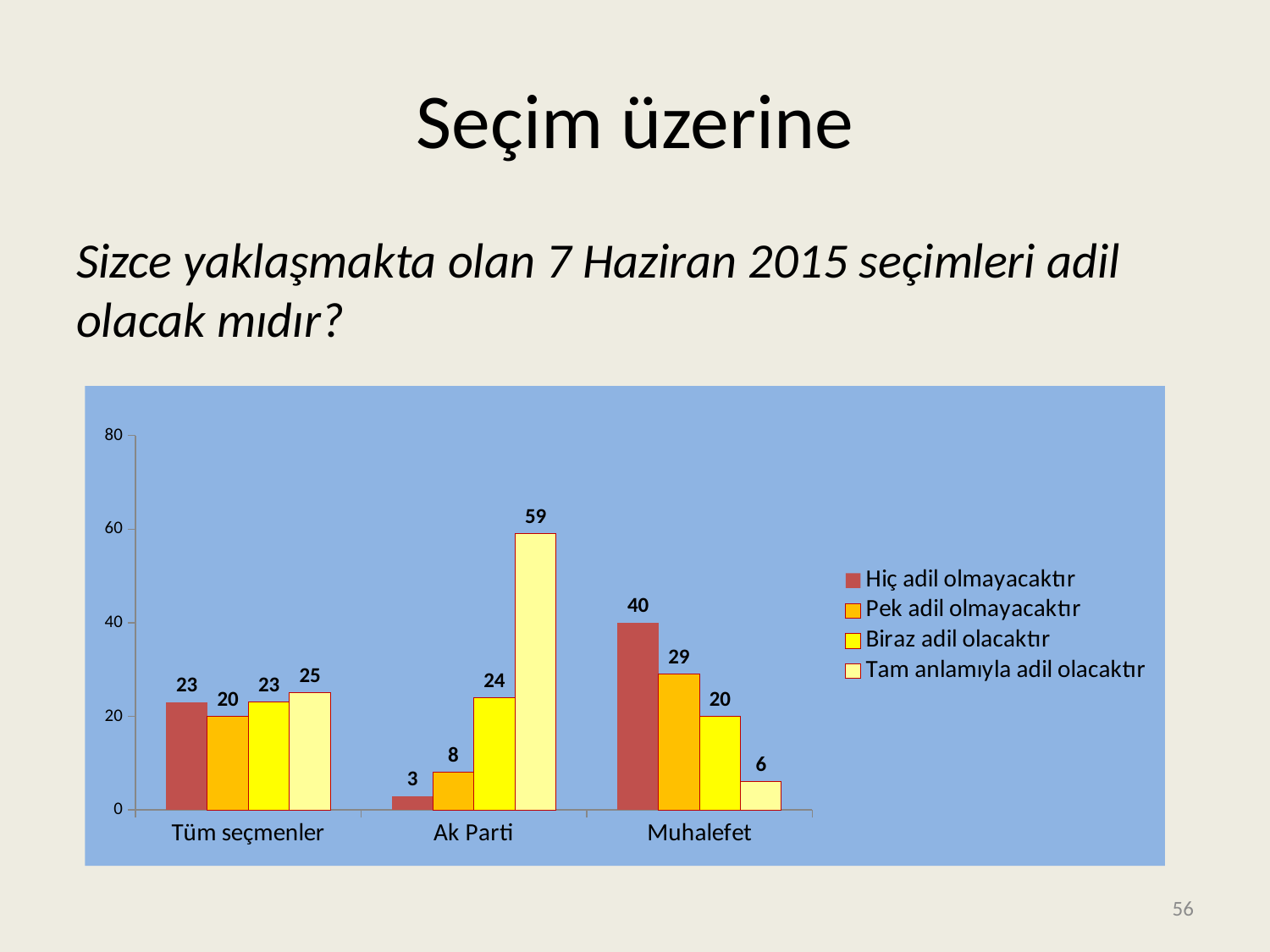
What is the difference between 'Hiç adil olmayacaktır' and 'Pek adil olmayacaktır' in the Muhalefet category? 11 What is the value for 'Hiç adil olmayacaktır' in the Muhalefet category? 40 Which series has the highest value in the Ak Parti category? Tam anlamıyla adil olacaktır How many categories are shown on the x axis? 3 Which is larger: 'Biraz adil olacaktır' for Ak Parti or 'Biraz adil olacaktır' for Muhalefet? Ak Parti What is the total of the four values in the Tüm seçmenler category? 91 What kind of chart is shown on the slide? bar chart What is the value for 'Tam anlamıyla adil olacaktır' in the Ak Parti category? 59 Which series has the lowest value in the Muhalefet category? Tam anlamıyla adil olacaktır How many series does the legend list? 4 Is the value for 'Tam anlamıyla adil olacaktır' in the Ak Parti category greater or less than 40? greater What is the value for 'Pek adil olmayacaktır' in the Tüm seçmenler category? 20